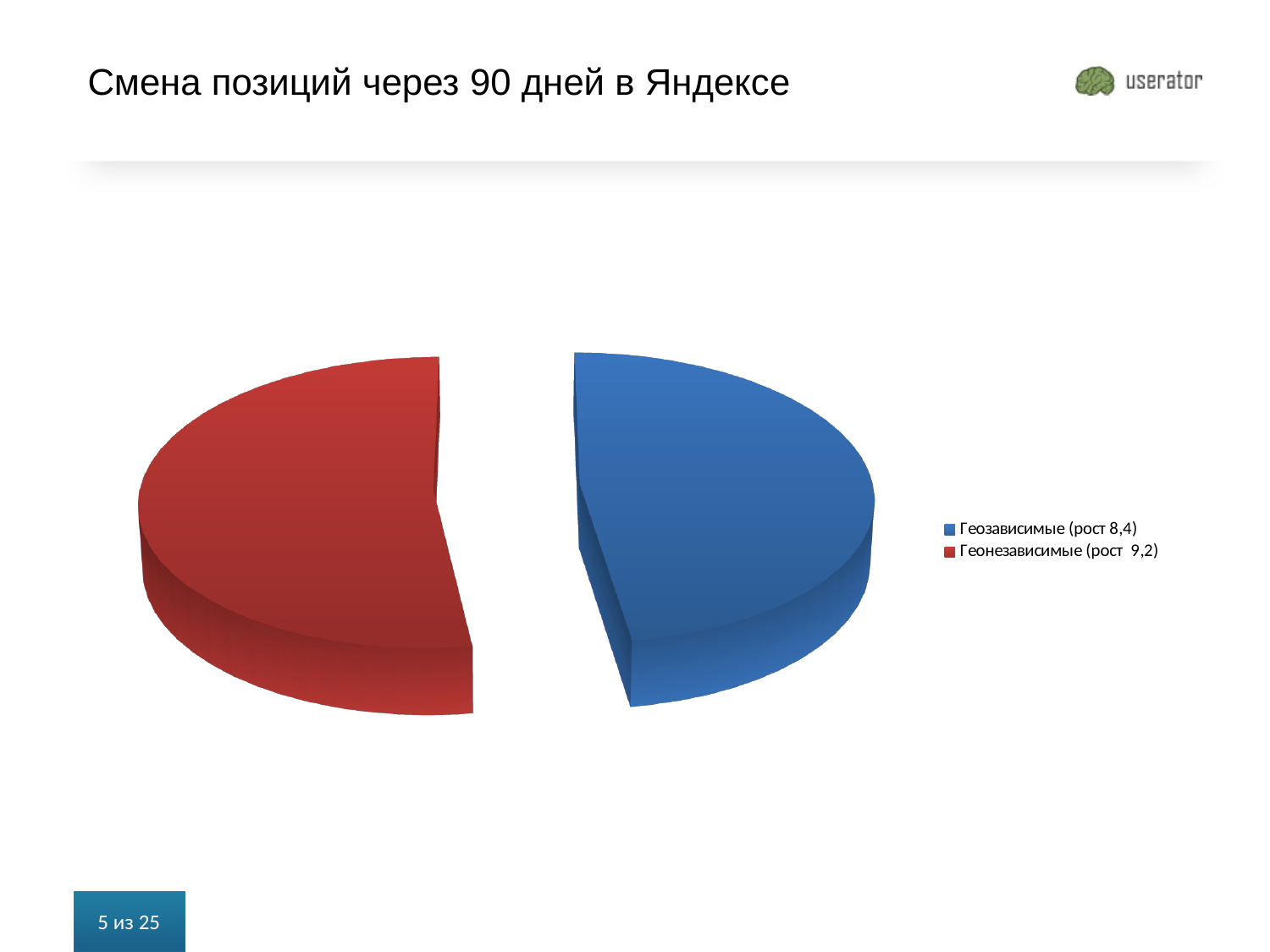
How many entries does the legend list? 2 How many slices does the pie chart have? 2 What growth value is given in the legend for Геозависимые? 8,4 Which category has the larger growth value, Геозависимые or Геонезависимые? Геонезависимые Which category has the highest growth value? Геонезависимые What is the title of the slide containing the pie chart? Смена позиций через 90 дней в Яндексе What kind of chart is shown on the slide? pie chart What growth value is given in the legend for Геонезависимые? 9,2 Which category has the lowest growth value? Геозависимые What is the difference between the growth values of Геонезависимые and Геозависимые? 0,8 What colour is the slice for Геозависимые? blue